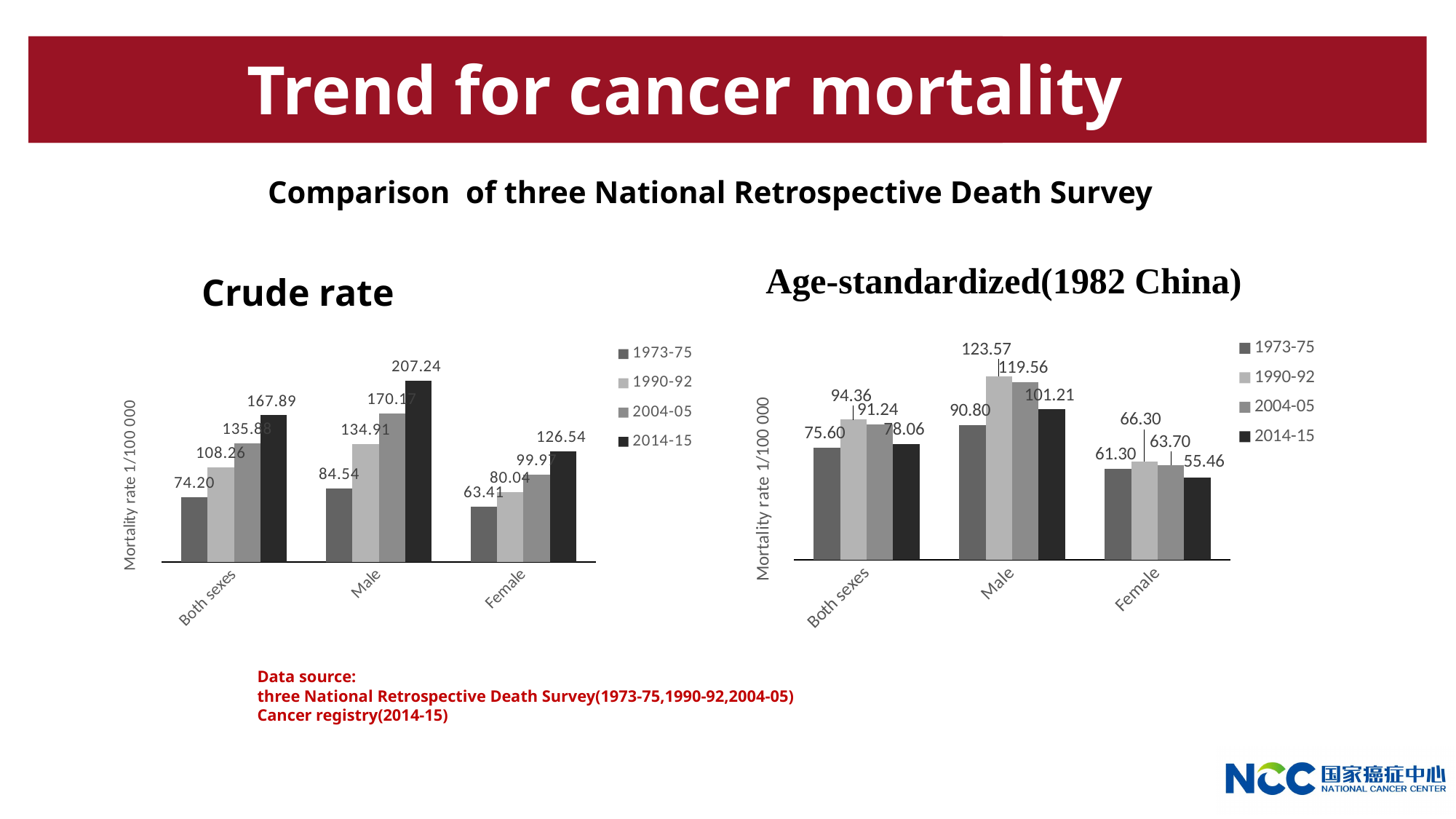
In the Crude rate chart, what is the mortality rate for Male in 2014-15? 207.24 In the Crude rate chart, what is the difference between the Female values for 2014-15 and 1973-75? 63.13 In the Age-standardized(1982 China) chart, which category has the lowest 1973-75 value? Female In the Age-standardized(1982 China) chart, which is larger for Both sexes: the 1990-92 value or the 2014-15 value? 1990-92 In the Crude rate chart, what is the mortality rate for Both sexes in 1973-75? 74.20 In the Crude rate chart, which category has the highest 2014-15 value? Male In the Age-standardized(1982 China) chart, what is the difference between the Male values for 1990-92 and 2004-05? 4.01 In the Age-standardized(1982 China) chart, what is the mortality rate for Male in 1990-92? 123.57 In the Age-standardized(1982 China) chart, what is the mortality rate for Female in 2014-15? 55.46 How many series does the legend of the Crude rate chart list? 4 How many categories are shown on the x axis of the Age-standardized(1982 China) chart? 3 What type of chart is the Crude rate chart? Bar chart